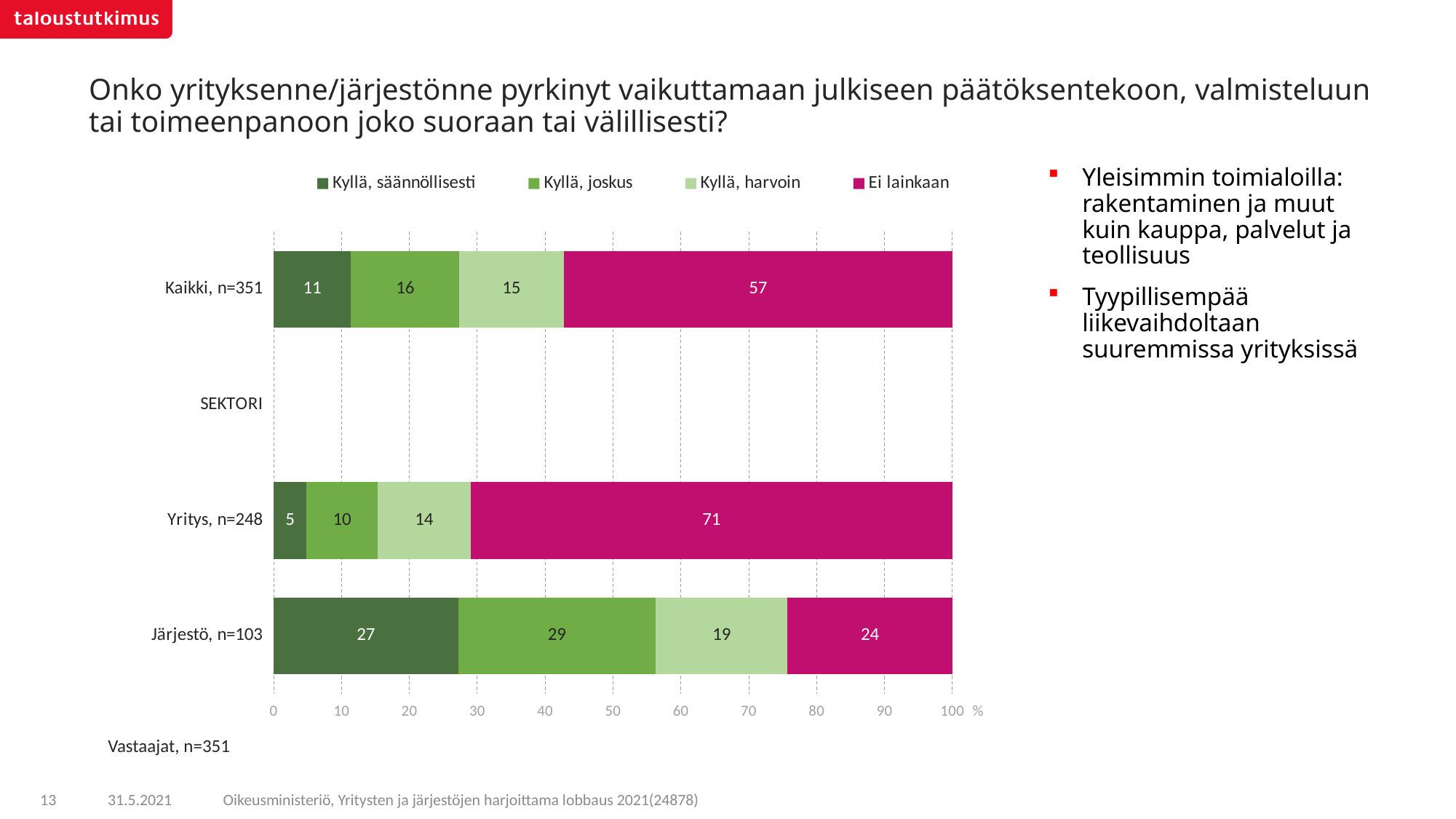
Which legend entry is shown in magenta/pink? Ei lainkaan How many categories with data bars are shown in the chart? 3 What is the total of the stacked bar for Järjestö, n=103? 99 How many series does the legend list? 4 Which is larger: "Kyllä, joskus" for Järjestö, n=103 or "Kyllä, joskus" for Kaikki, n=351? Järjestö, n=103 What is the difference between the "Ei lainkaan" values for Yritys, n=248 and Järjestö, n=103? 47 Which category has the highest value for "Ei lainkaan"? Yritys, n=248 What is the value of "Kyllä, harvoin" for Yritys, n=248? 14 What is the value of "Ei lainkaan" for Kaikki, n=351? 57 Which category has the lowest value for "Kyllä, säännöllisesti"? Yritys, n=248 What is the value of "Kyllä, säännöllisesti" for Järjestö, n=103? 27 What kind of chart is shown on the slide? Stacked bar chart